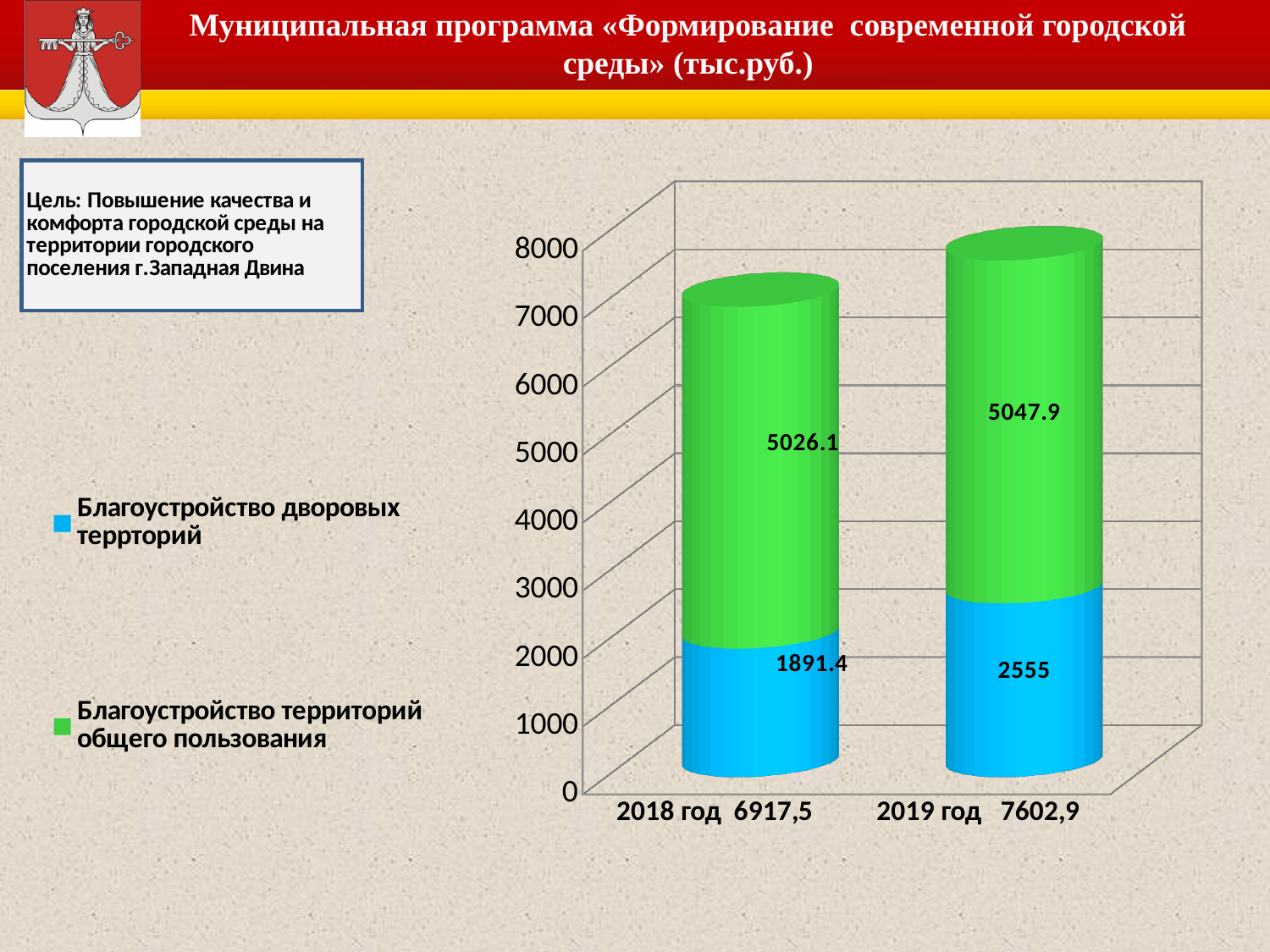
What is the total of the stacked bar for 2018 год? 6917,5 What is the total of the stacked bar for 2019 год? 7602,9 What kind of chart is shown on the slide? Stacked bar chart How many series does the legend list? 2 Which colour represents «Благоустройство территорий общего пользования» in the chart? Green What is the value for «Благоустройство территорий общего пользования» in 2019 год? 5047.9 What is the value for «Благоустройство дворовых терpторий» in 2018 год? 1891.4 How many categories are shown on the x axis? 2 What is the value for «Благоустройство территорий общего пользования» in 2018 год? 5026.1 Which year has the larger value for «Благоустройство дворовых терpторий», 2018 год or 2019 год? 2019 год What is the value for «Благоустройство дворовых терpторий» in 2019 год? 2555 By how much did the value for «Благоустройство дворовых терpторий» change from 2018 год to 2019 год? 663.6